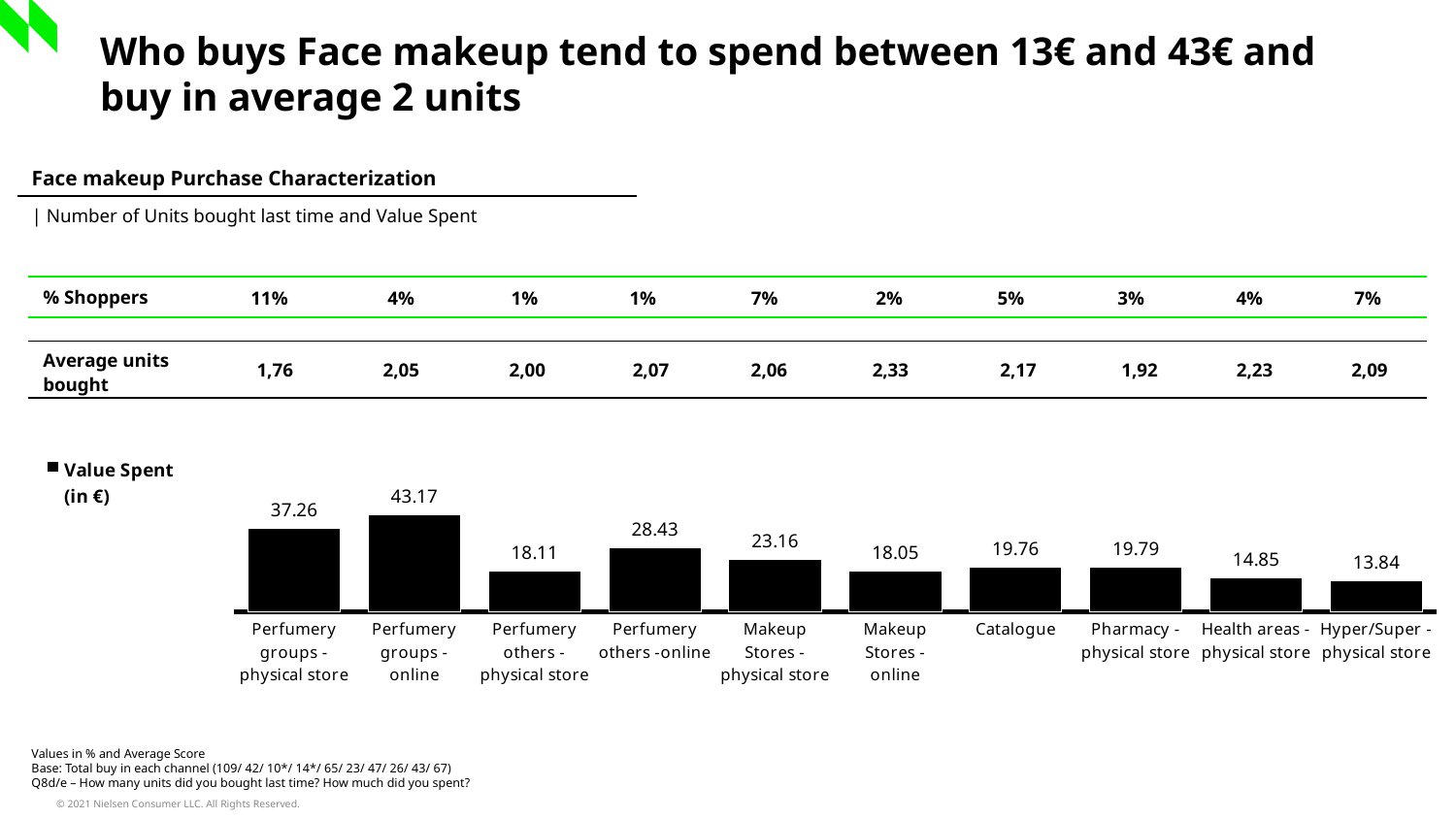
How many series does the legend of the chart list? 1 Which channel has the lowest value spent? Hyper/Super - physical store Which channel has the highest value spent? Perfumery groups - online Which has a larger value spent: Health areas - physical store or Perfumery others - physical store? Perfumery others - physical store What is the value spent (in €) for Perfumery groups - online? 43.17 Which has a larger value spent: Makeup Stores - physical store or Makeup Stores - online? Makeup Stores - physical store What is the value spent (in €) for Catalogue? 19.76 How many channels are shown in the Value Spent chart? 10 What is the difference in value spent between Perfumery others - online and Perfumery others - physical store? 10.32 What kind of chart is used to show Value Spent? Bar chart What is the difference in value spent between Perfumery groups - online and Perfumery groups - physical store? 5.91 What is the value spent (in €) for Makeup Stores - physical store? 23.16